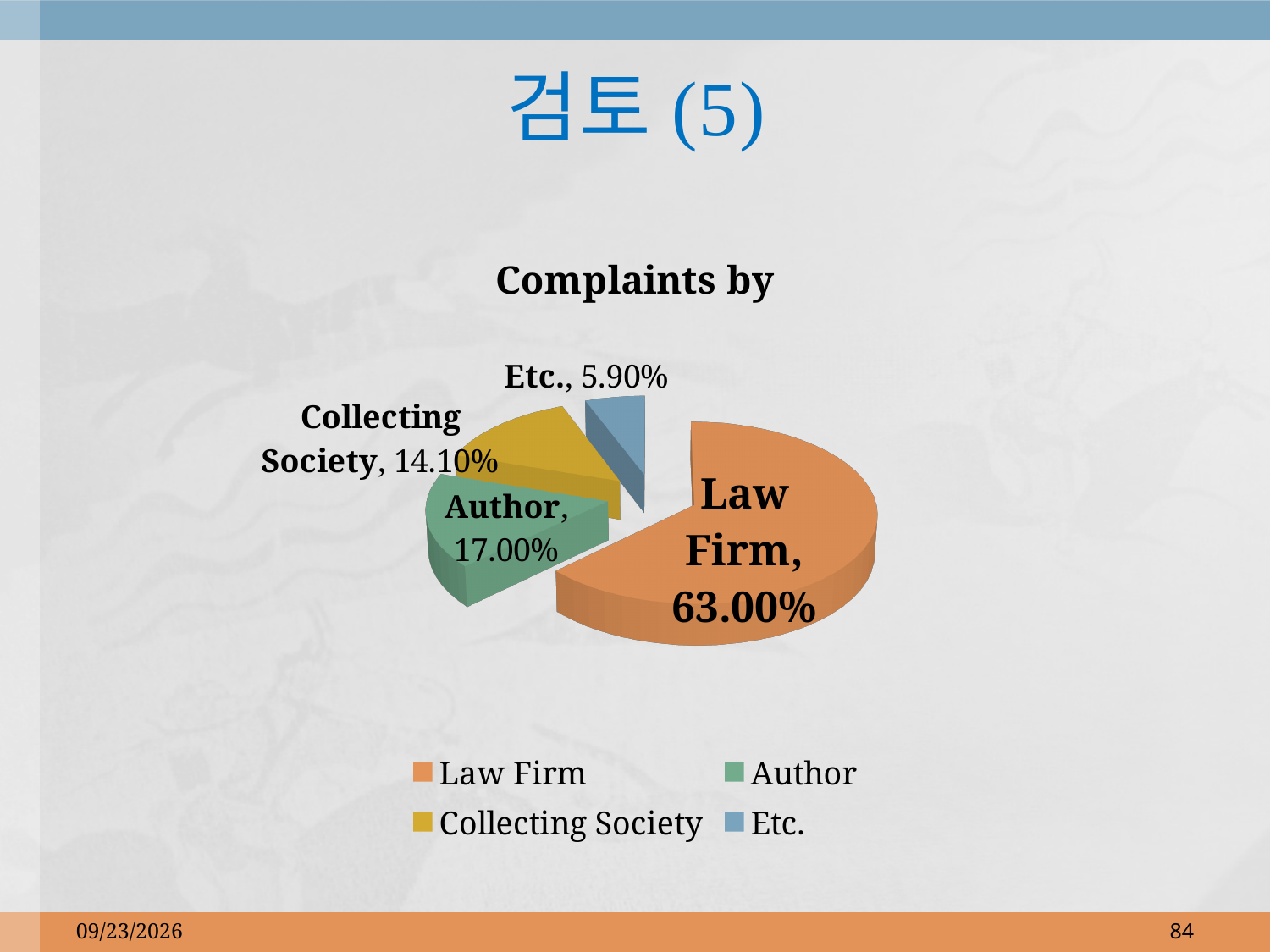
What is the difference in percentage points between Law Firm and Author? 46.00% Which category has the smallest share of complaints? Etc. What percentage of complaints are by Law Firm? 63.00% How many categories are shown in the pie chart? 4 What type of chart is shown on the slide? Pie chart Which category has the largest share of complaints? Law Firm What percentage of complaints are by Etc.? 5.90% What is the title of the chart? Complaints by What percentage of complaints are by Author? 17.00% What percentage of complaints are by Collecting Society? 14.10% Which has a larger share, Author or Collecting Society? Author What colour represents Collecting Society in the chart? Yellow